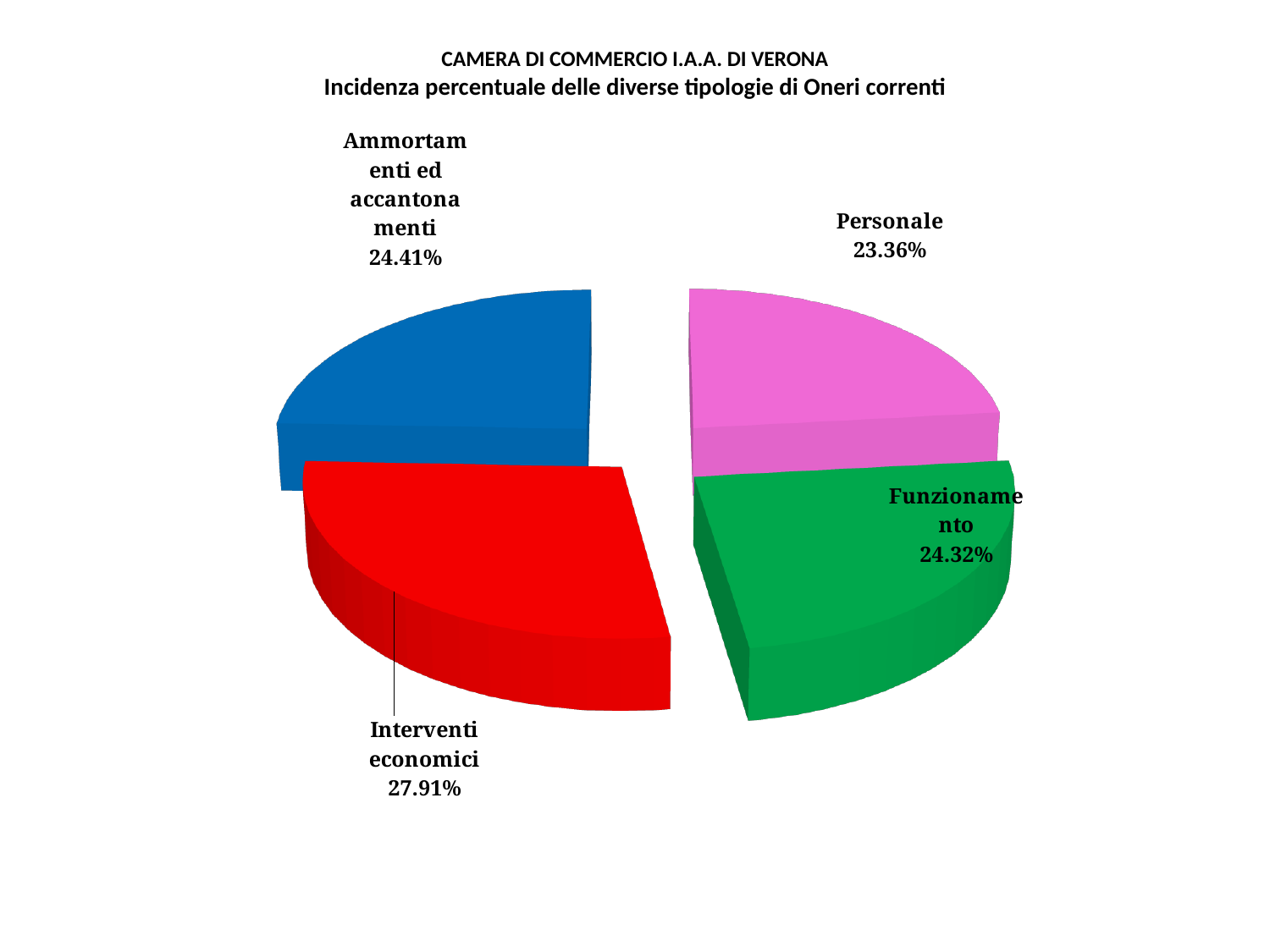
What kind of chart is shown on the slide? Pie chart What percentage is shown for Funzionamento? 24.32% What percentage is shown for Ammortamenti ed accantonamenti? 24.41% What is the difference between the shares of Ammortamenti ed accantonamenti and Funzionamento? 0.09% Which is larger, the share for Interventi economici or the share for Funzionamento? Interventi economici What colour is the slice for Interventi economici? Red What is the value shown for Personale? 23.36% Which category has the smallest share of the pie? Personale How many categories are shown in the pie chart? 4 What share of the pie does Interventi economici represent? 27.91% Which category has the largest share of the pie? Interventi economici What is the difference between the shares of Interventi economici and Personale? 4.55%